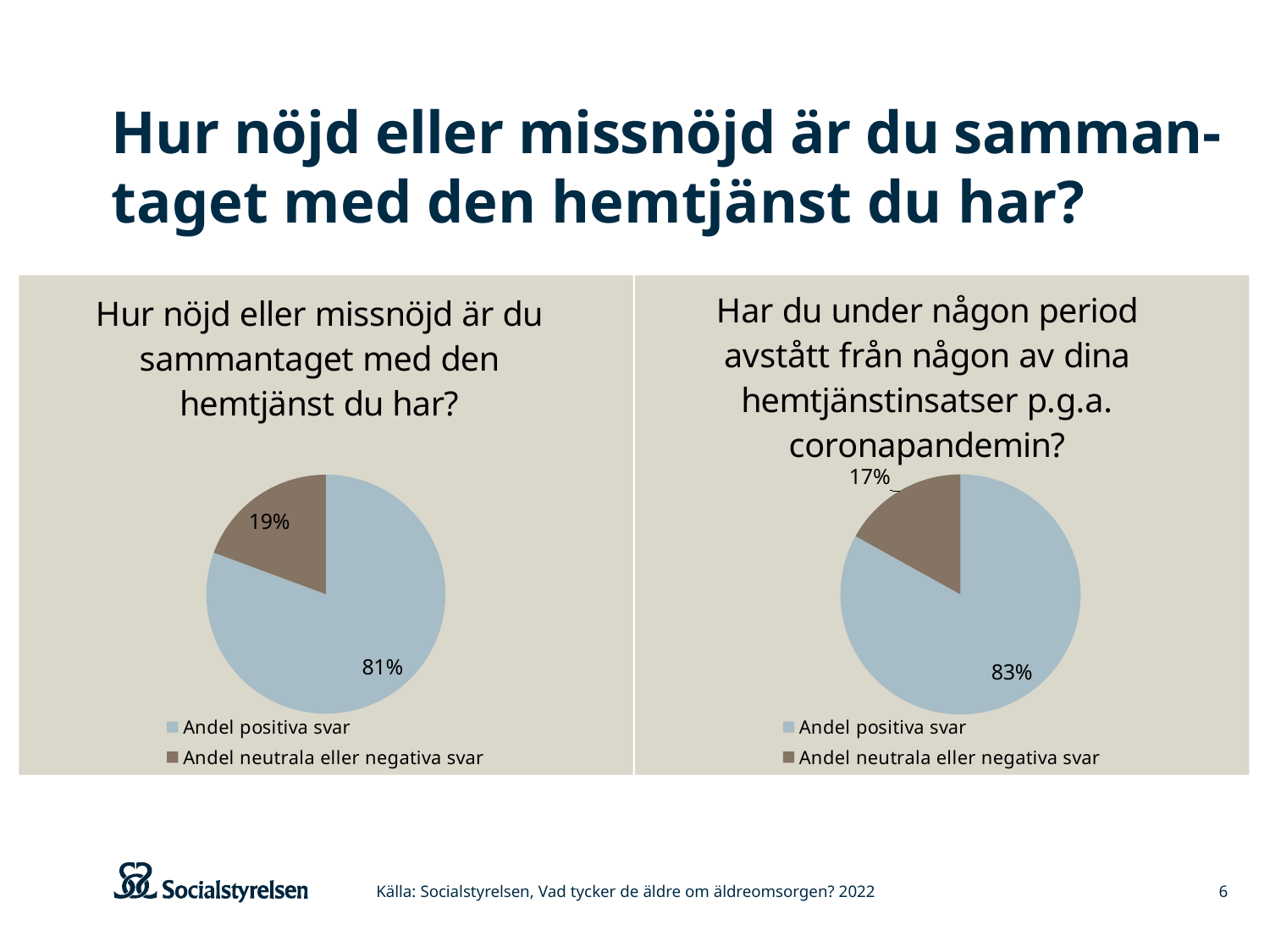
In the right pie chart, what share is labelled for 'Andel positiva svar'? 83% In the right pie chart, which slice is the smallest? Andel neutrala eller negativa svar What type of chart is used on the left side of the slide? Pie chart How many entries does the legend of the left pie chart list? 2 What is the difference between the two slices in the left pie chart? 62 percentage points What is the title of the right pie chart? Har du under någon period avstått från någon av dina hemtjänstinsatser p.g.a. coronapandemin? In the right pie chart, what share is labelled for 'Andel neutrala eller negativa svar'? 17% In the left pie chart, what share is labelled for 'Andel neutrala eller negativa svar'? 19% In the left pie chart, which slice is the largest? Andel positiva svar In the left pie chart, what share is labelled for 'Andel positiva svar'? 81% Which is larger: the 'Andel positiva svar' slice in the left chart or in the right chart? The right chart How many slices does the right pie chart have? 2